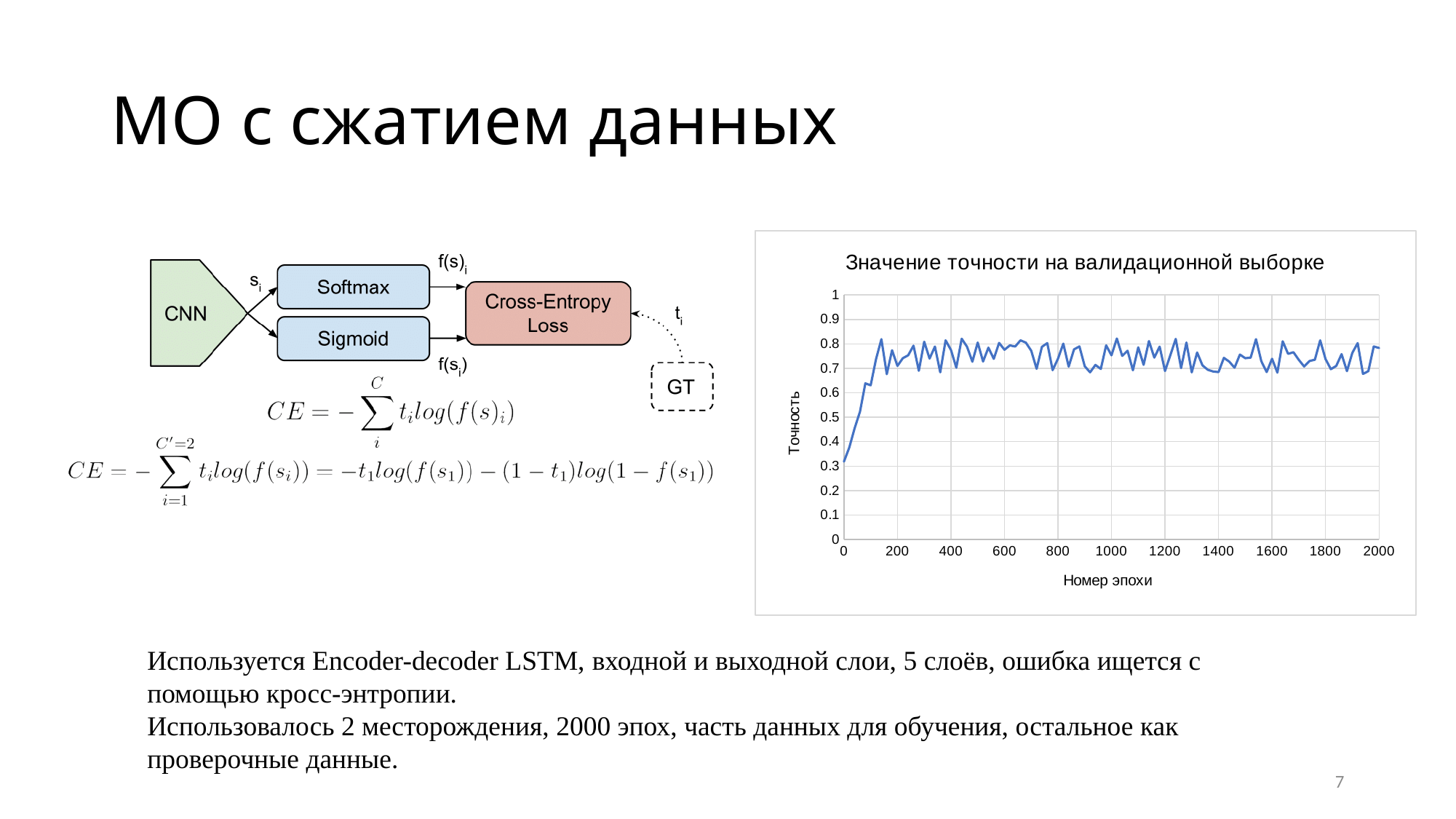
Is the accuracy value at epoch 2000 greater or less than 0.6? greater What is the title of the chart? Значение точности на валидационной выборке Is the accuracy at epoch 2000 higher or lower than at epoch 0? higher What is the label of the x axis of the chart? Номер эпохи Does the accuracy rise or fall between epoch 0 and epoch 200? rise Is the accuracy value at epoch 1000 greater or less than 0.5? greater Is the accuracy value at epoch 600 greater or less than 0.9? less What kind of chart is shown on the slide? line chart How many data series are plotted on the chart? 1 What is the largest value shown on the x axis of the chart? 2000